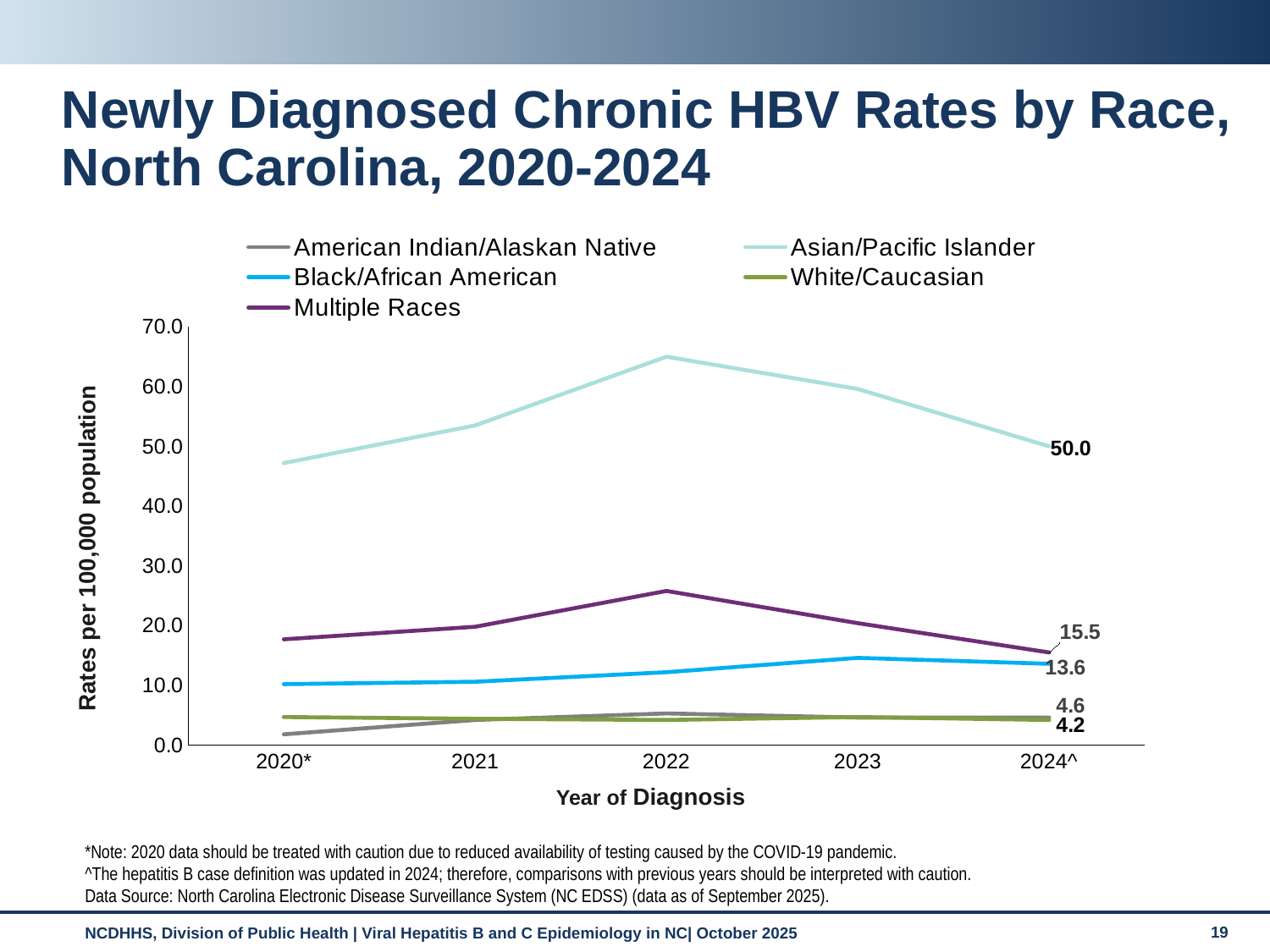
What is the rate for Asian/Pacific Islander in 2024^? 50.0 What is the title of the y axis? Rates per 100,000 population What is the difference between the Asian/Pacific Islander rate and the Multiple Races rate in 2024^? 34.5 What is the rate for Black/African American in 2024^? 13.6 In which year does the Asian/Pacific Islander line reach its peak? 2022 What is the rate for Multiple Races in 2024^? 15.5 Is the Asian/Pacific Islander rate in 2022 greater or less than 60.0? greater What kind of chart is shown on the slide? Line chart How many years are shown on the x axis? 5 In 2024^, which is larger: the rate for Multiple Races or the rate for Black/African American? Multiple Races Which race group has the highest rate in 2024^? Asian/Pacific Islander How many series does the legend list? 5